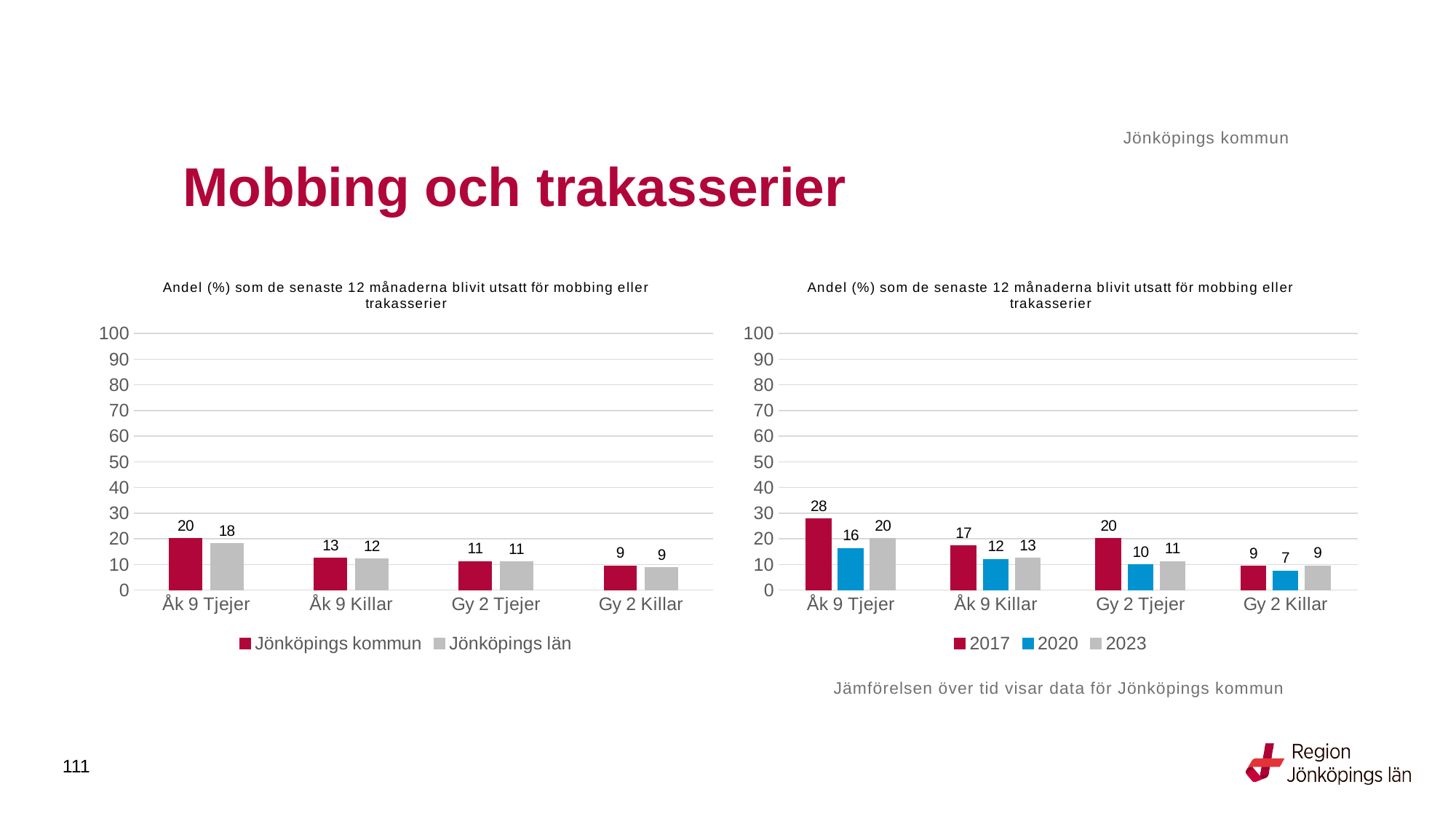
In the left chart, which category has the lowest value for Jönköpings kommun? Gy 2 Killar In the right chart, what is the value for 2020 for Gy 2 Killar? 7 In the left chart, what is the difference between Jönköpings kommun and Jönköpings län for Åk 9 Tjejer? 2 In the left chart, what is the value for Jönköpings kommun for Åk 9 Tjejer? 20 In the right chart, what is the value for 2017 for Åk 9 Tjejer? 28 What kind of chart is the right chart? Bar chart In the right chart, how many categories are shown on the x axis? 4 In the left chart, how many series does the legend list? 2 In the right chart, which is larger for Åk 9 Killar: the 2017 value or the 2023 value? 2017 In the right chart, which category has the highest value for 2017? Åk 9 Tjejer In the left chart, what is the value for Jönköpings län for Åk 9 Killar? 12 In the right chart, what is the difference between 2017 and 2020 for Gy 2 Tjejer? 10